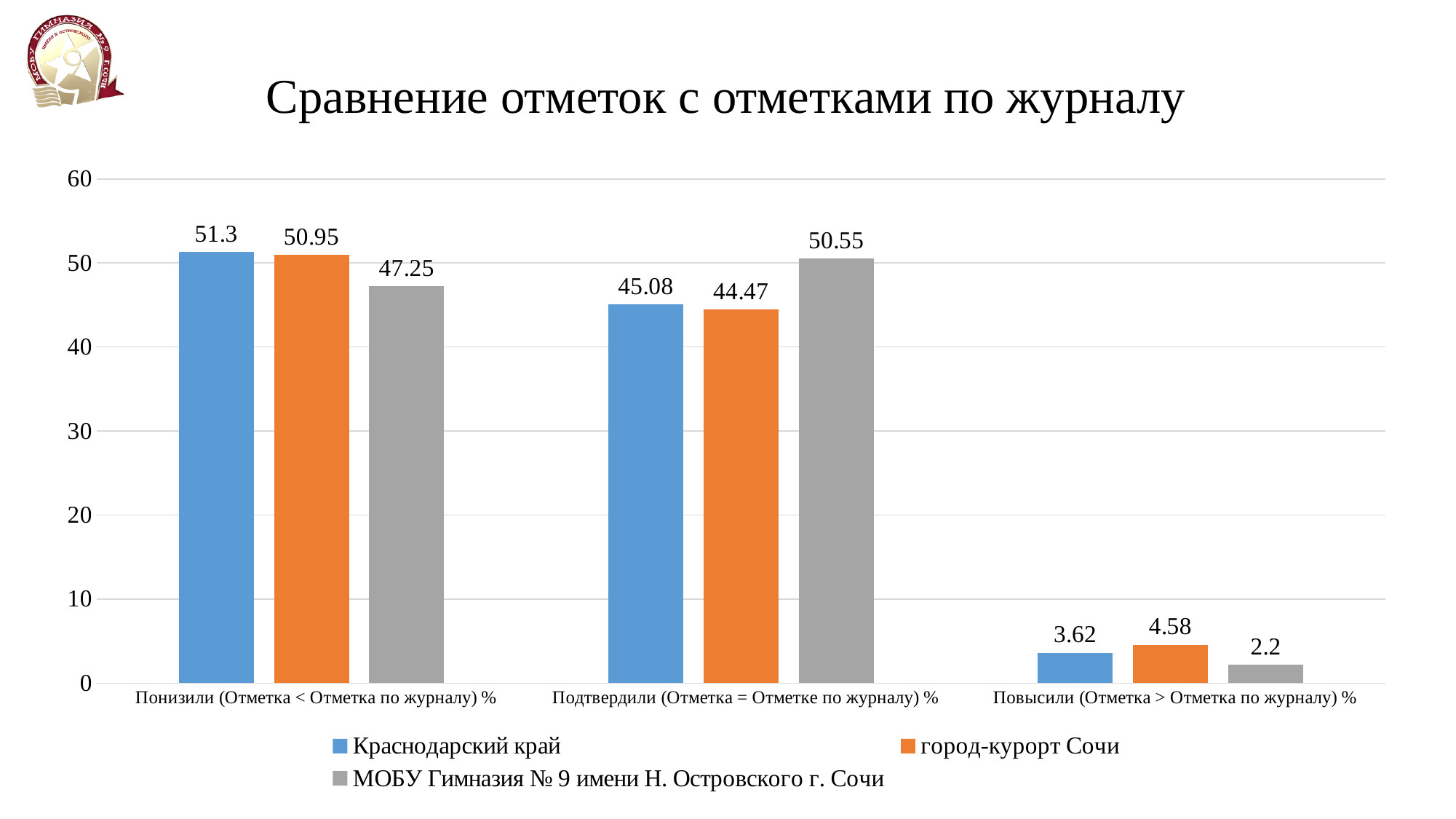
How many series does the legend list? 3 How many categories are shown on the x axis of the chart? 3 What value does the chart show for МОБУ Гимназия № 9 имени Н. Островского г. Сочи in the category Подтвердили (Отметка = Отметке по журналу) %? 50.55 Which series has the lowest value in the category Повысили (Отметка > Отметка по журналу) %? МОБУ Гимназия № 9 имени Н. Островского г. Сочи Which series has the highest value in the category Подтвердили (Отметка = Отметке по журналу) %? МОБУ Гимназия № 9 имени Н. Островского г. Сочи In the category Повысили (Отметка > Отметка по журналу) %, which is larger: the value for Краснодарский край or for город-курорт Сочи? город-курорт Сочи What value does the chart show for город-курорт Сочи in the category Повысили (Отметка > Отметка по журналу) %? 4.58 Is the value for город-курорт Сочи in the category Подтвердили (Отметка = Отметке по журналу) % greater or less than 50? less What kind of chart is shown on the slide? bar chart What value does the chart show for Краснодарский край in the category Понизили (Отметка < Отметка по журналу) %? 51.3 What is the title of the slide? Сравнение отметок с отметками по журналу What is the difference between the values for Краснодарский край and МОБУ Гимназия № 9 имени Н. Островского г. Сочи in the category Понизили (Отметка < Отметка по журналу) %? 4.05